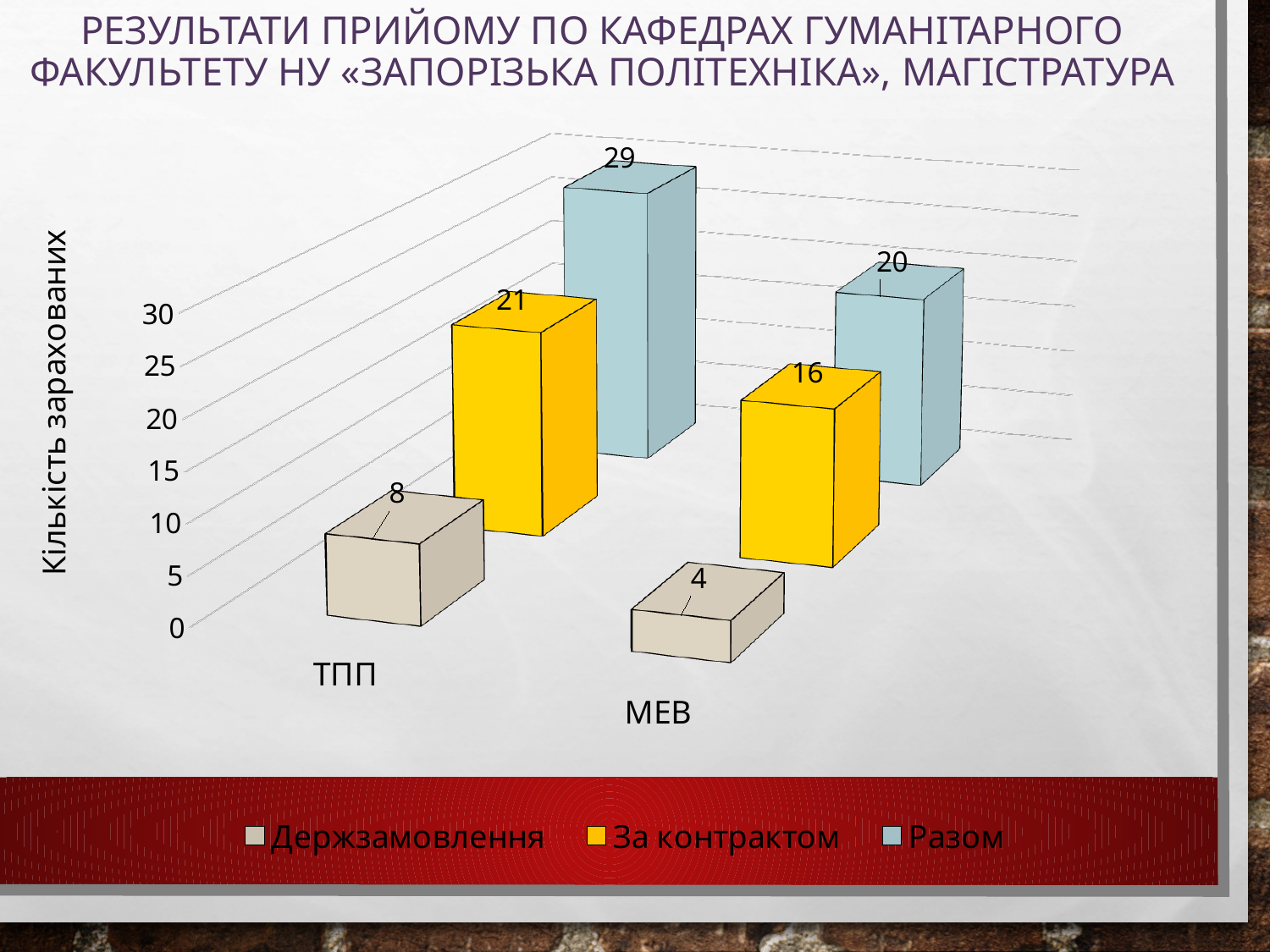
Which is larger: Разом for ТПП or Разом for МЕВ? Разом for ТПП What is the value for За контрактом for МЕВ? 16 What kind of chart is shown on the slide? bar chart Which category has the lowest value for Держзамовлення? МЕВ What is the value for Разом for ТПП? 29 What is the difference between the За контрактом values for ТПП and МЕВ? 5 How many series does the legend list? 3 What is the value for Держзамовлення for ТПП? 8 How many categories are shown on the x axis? 2 What is the label of the vertical axis? Кількість зарахованих What is the value for Держзамовлення for МЕВ? 4 Which category has the highest value for Разом? ТПП